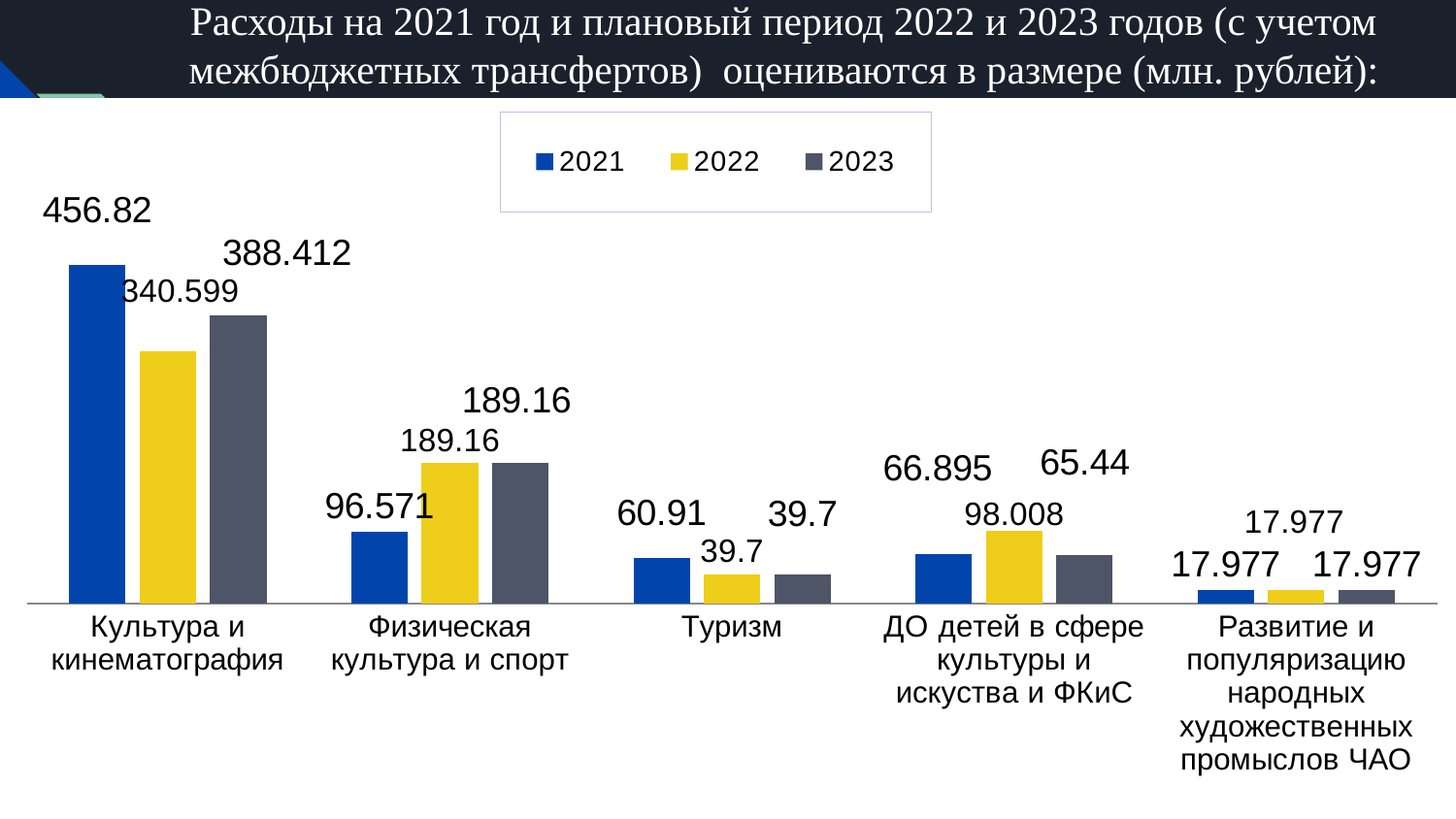
What is the 2023 value for ДО детей в сфере культуры и искуства и ФКиС? 65.44 Which category has the highest 2021 value? Культура и кинематография How many categories are shown on the x axis? 5 Which series is shown in yellow in the legend? 2022 For ДО детей в сфере культуры и искуства и ФКиС, which is larger: the 2022 value or the 2021 value? 2022 Which category has the lowest 2023 value? Развитие и популяризацию народных художественных промыслов ЧАО What type of chart is shown on the slide? bar chart What is the difference between the 2021 and 2022 values for Культура и кинематография? 116.221 What is the 2022 value for Физическая культура и спорт? 189.16 What is the 2021 value for Культура и кинематография? 456.82 What is the 2022 value for Туризм? 39.7 How many series does the legend list? 3